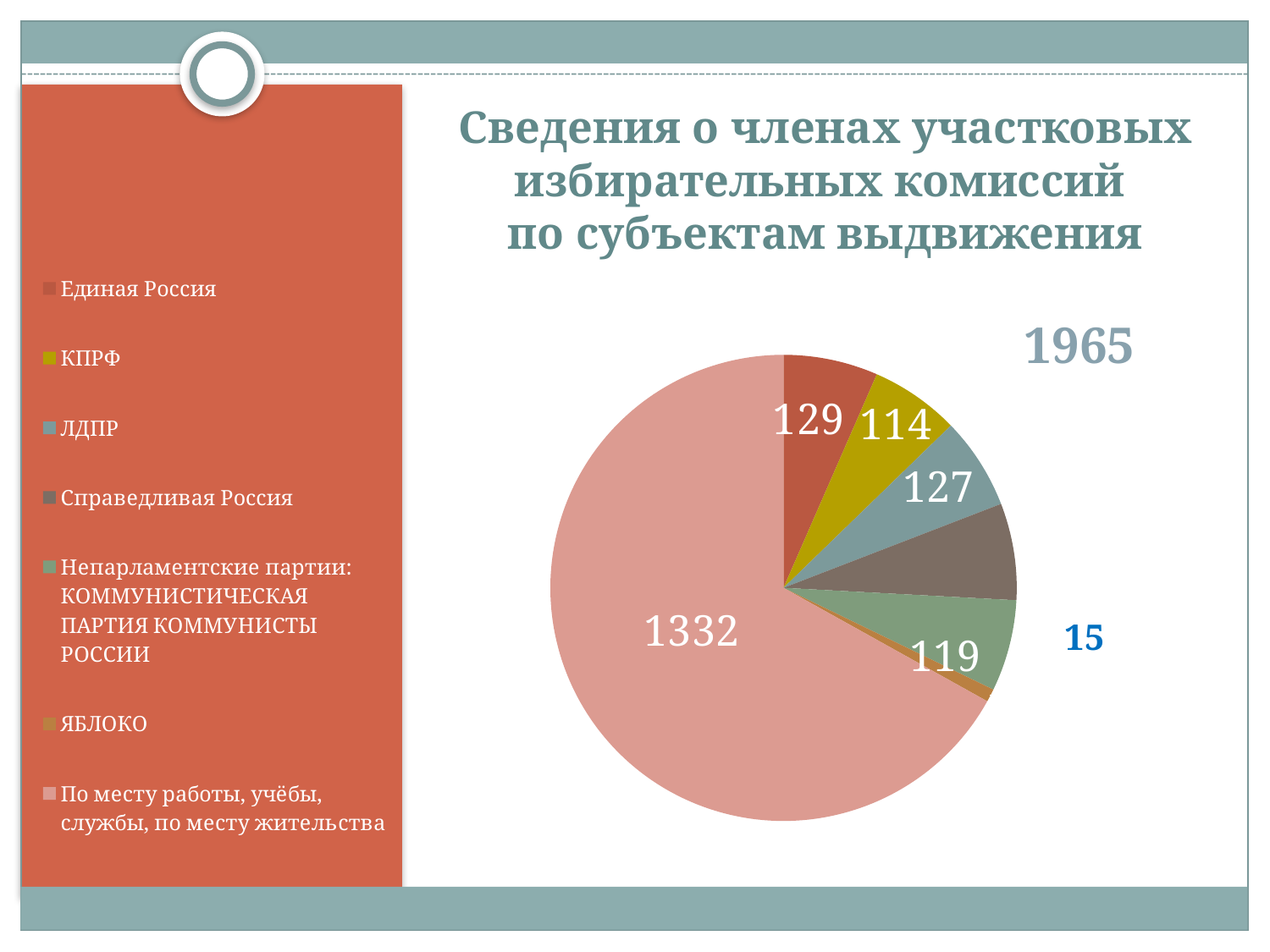
Which category has the smallest slice of the pie? ЯБЛОКО What is the difference between the values for Единая Россия and КПРФ? 15 What is the value for По месту работы, учёбы, службы, по месту жительства? 1332 What is the value for КПРФ? 114 What type of chart is shown on the slide? pie chart How many categories does the legend list? 7 What is the value for Непарламентские партии: КОММУНИСТИЧЕСКАЯ ПАРТИЯ КОММУНИСТЫ РОССИИ? 119 What is the value for ЛДПР? 127 Which is larger, the value for ЛДПР or the value for КПРФ? ЛДПР What is the value for ЯБЛОКО? 15 What is the value for Единая Россия? 129 Which category has the largest slice of the pie? По месту работы, учёбы, службы, по месту жительства